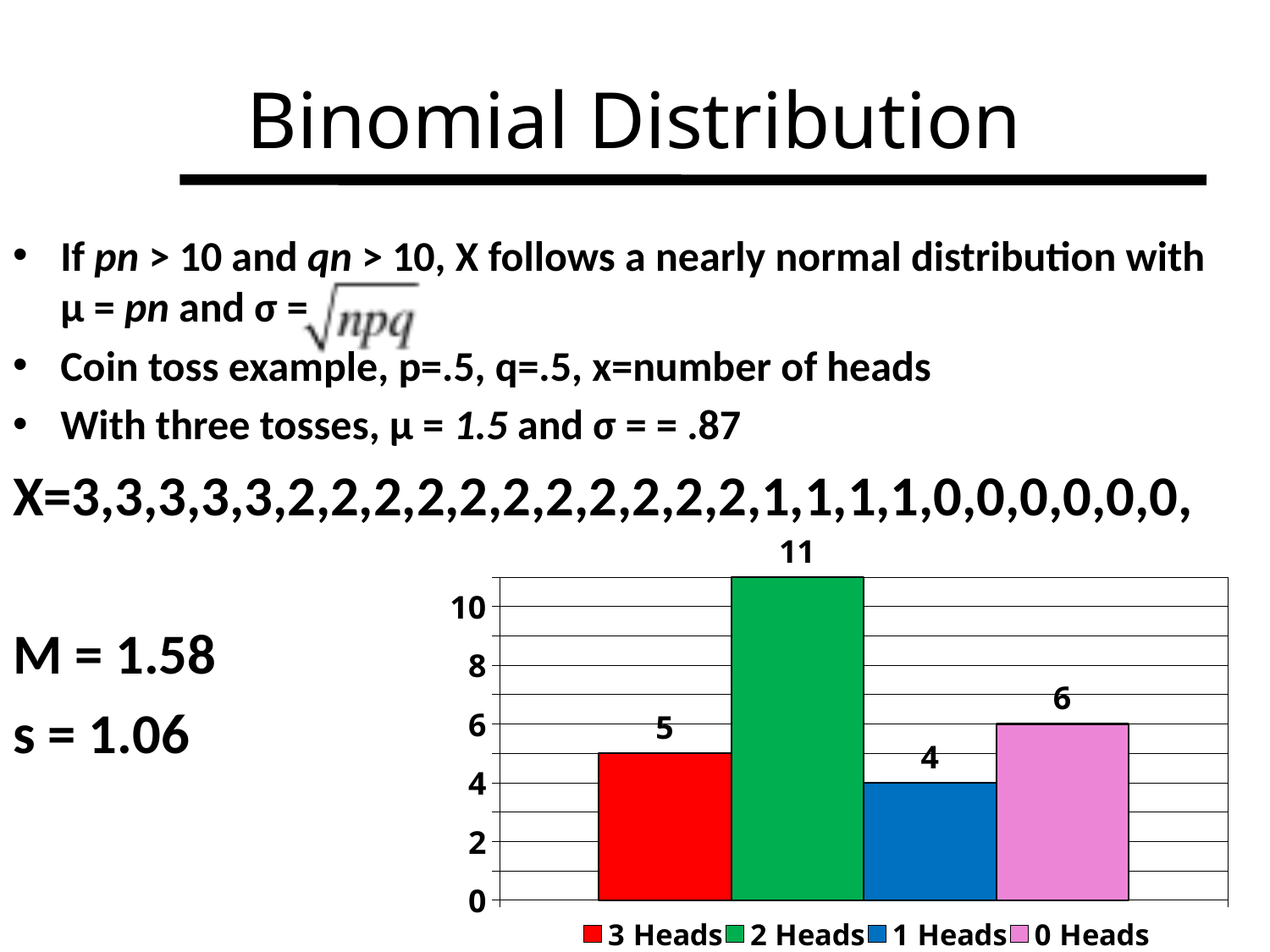
What kind of chart is shown on the slide? bar chart Is the value for 2 Heads greater or less than 10? greater What is the value for 0 Heads? 6 What colour is the bar for 2 Heads? green Which is larger, the value for 0 Heads or the value for 3 Heads? 0 Heads What is the value for 1 Heads? 4 Which category has the lowest value? 1 Heads What is the value for 3 Heads? 5 What is the difference between the values for 2 Heads and 3 Heads? 6 How many bars are shown in the chart? 4 What is the value for 2 Heads? 11 Which category has the highest value? 2 Heads